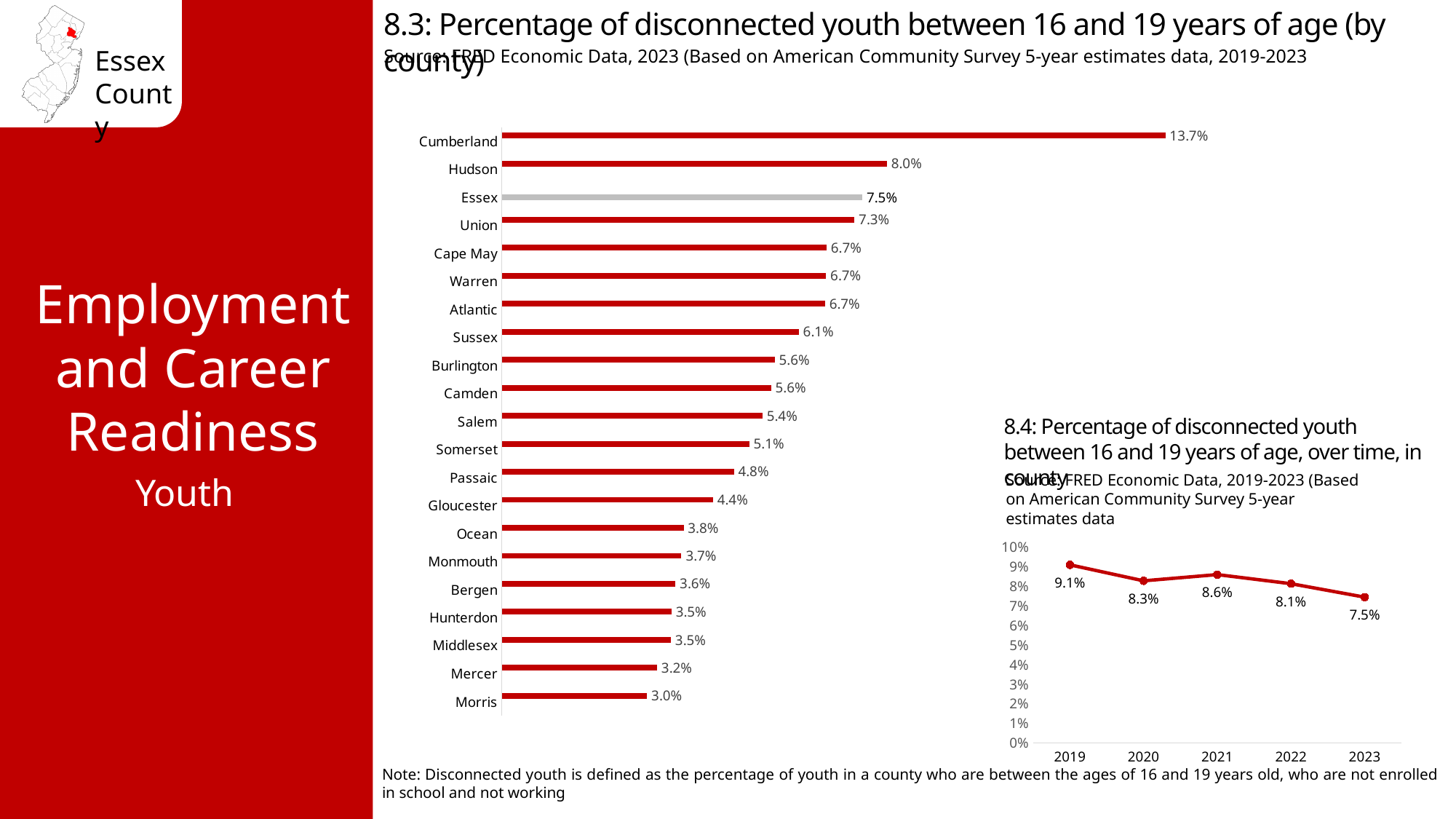
In the 8.4 line chart, do the values generally rise or fall from 2019 to 2023? Fall In the 8.3 bar chart, what is the difference between Cumberland's and Hudson's values? 5.7% In the 8.3 bar chart, what is the value for Gloucester? 4.4% What kind of chart is chart 8.3? Bar chart In the 8.3 bar chart, what is the percentage of disconnected youth for Essex? 7.5% In the 8.4 line chart, what is the difference between the 2019 and 2023 values? 1.6% In the 8.3 bar chart, which county has the highest percentage of disconnected youth? Cumberland In the 8.4 line chart, which year has the lowest value? 2023 In the 8.3 bar chart, which county has the lowest percentage of disconnected youth? Morris In the 8.3 bar chart, which has a higher value, Union or Sussex? Union How many counties are shown in the 8.3 bar chart? 21 In the 8.4 line chart, what was the percentage of disconnected youth in 2019? 9.1%